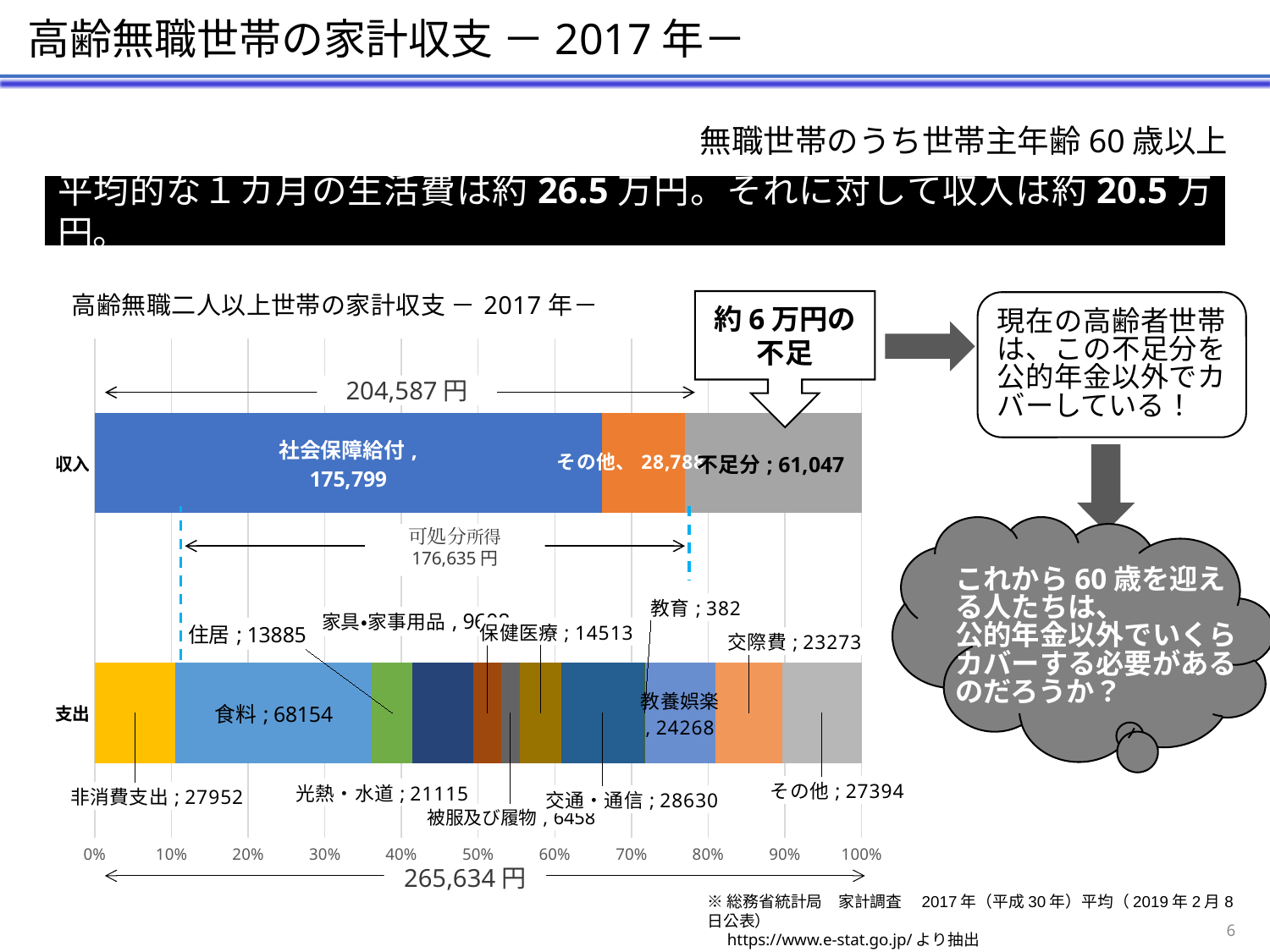
What is the value for 不足分 in the 収入 bar? 61,047 What is the total of the 支出 bar as printed on the slide? 265,634 円 What is the difference between 交通・通信 and 交際費 in the 支出 bar? 5357 What kind of chart is shown on the slide? Stacked bar chart What is the value of 可処分所得 shown between the two bars? 176,635 円 Which category in the 支出 bar has the smallest value? 教育 What total is printed above the 収入 bar (excluding 不足分)? 204,587 円 Which is larger in the 支出 bar, 非消費支出 or その他? 非消費支出 What is the value for 社会保障給付 in the 収入 bar? 175,799 How many bars does the chart have? 2 What is the value for 食料 in the 支出 bar? 68154 Which category in the 支出 bar has the largest value? 食料